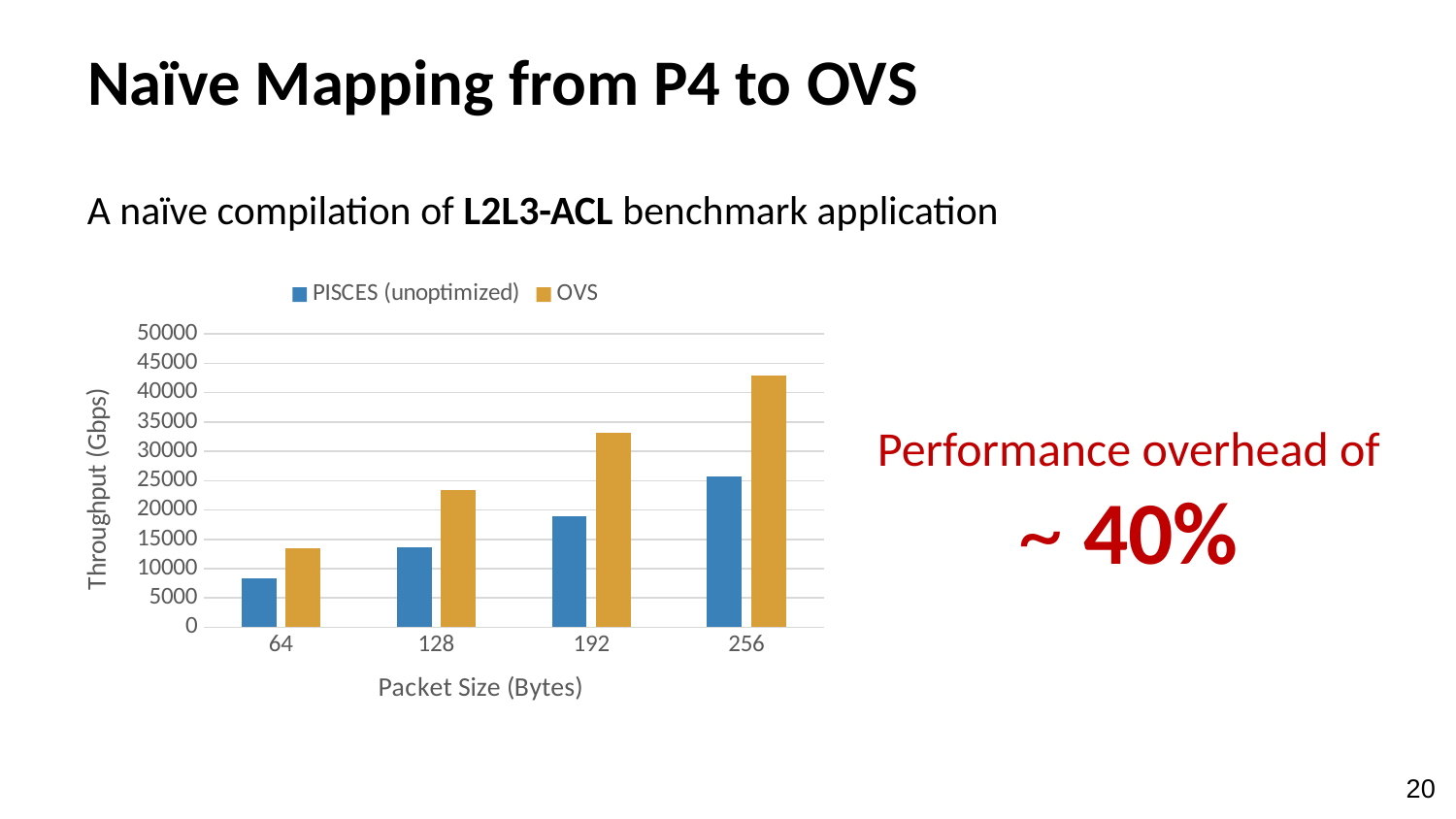
Is the OVS throughput at packet size 256 greater or less than 40000? greater How many packet size categories are shown on the x axis? 4 Which packet size has the highest OVS throughput? 256 Is the OVS throughput at packet size 192 greater or less than 30000? greater What kind of chart is shown on the slide? bar chart Is the PISCES (unoptimized) throughput at packet size 64 greater or less than 10000? less How many series does the legend list? 2 Does the OVS throughput rise or fall as packet size increases along the x axis? rise Which packet size has the lowest PISCES (unoptimized) throughput? 64 What is the label of the y axis? Throughput (Gbps) At a packet size of 192 bytes, which series has the higher throughput, PISCES (unoptimized) or OVS? OVS